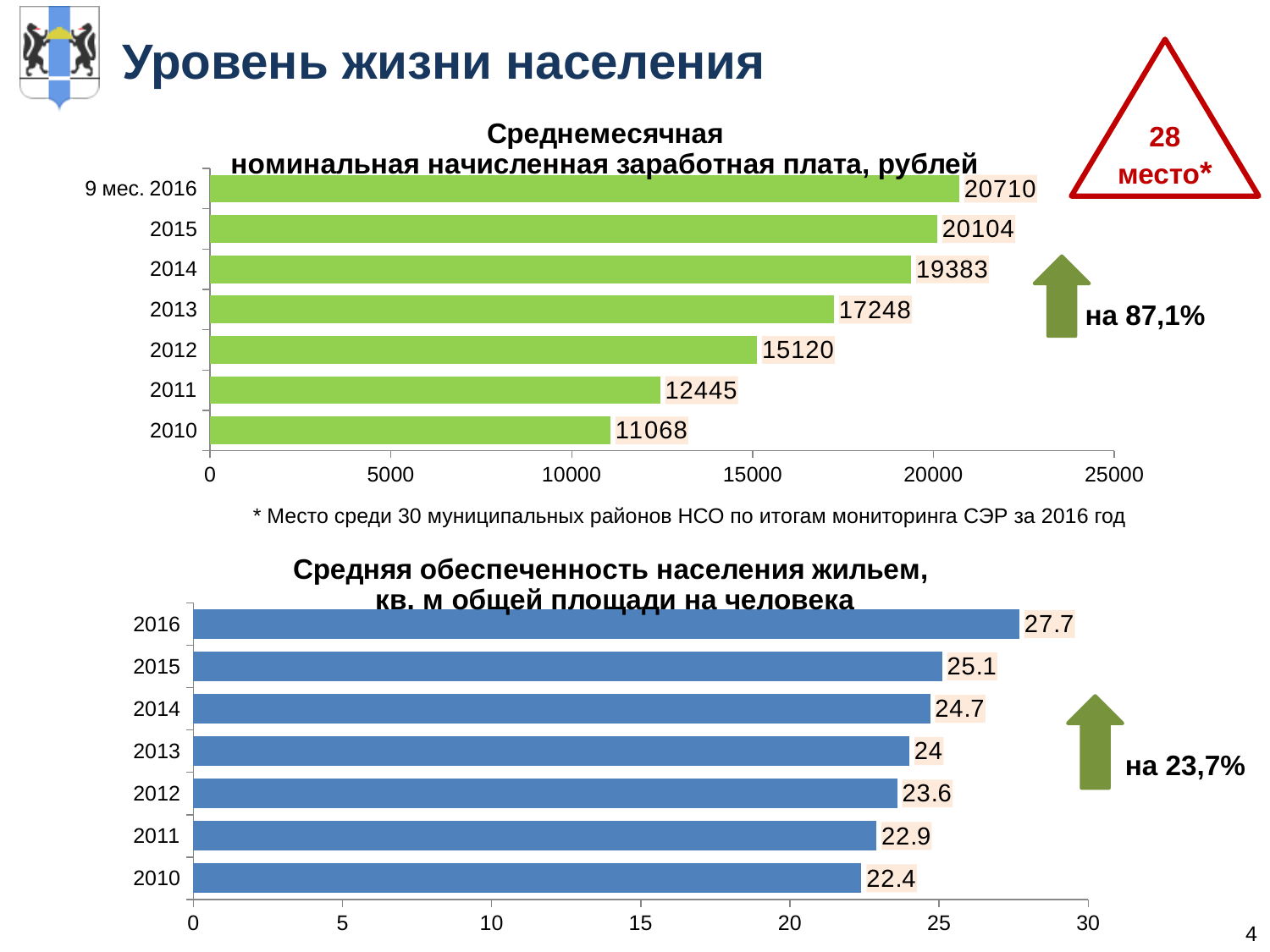
In the bottom chart (Средняя обеспеченность населения жильем), which is larger, the value for 2011 or the value for 2013? 2013 In the top chart (Среднемесячная номинальная начисленная заработная плата, рублей), what is the value for 2013? 17248 What type of chart is the bottom chart (Средняя обеспеченность населения жильем)? bar chart In the top chart (Среднемесячная номинальная начисленная заработная плата, рублей), how many categories are shown? 7 In the top chart (Среднемесячная номинальная начисленная заработная плата, рублей), which category has the lowest value? 2010 In the bottom chart (Средняя обеспеченность населения жильем), what is the difference between the values for 2016 and 2015? 2.6 In the top chart (Среднемесячная номинальная начисленная заработная плата, рублей), what is the value for 9 мес. 2016? 20710 What colour are the bars in the top chart (Среднемесячная номинальная начисленная заработная плата, рублей)? green In the top chart (Среднемесячная номинальная начисленная заработная плата, рублей), do the values rise or fall from 2010 to 9 мес. 2016? rise In the top chart (Среднемесячная номинальная начисленная заработная плата, рублей), what is the difference between the values for 2015 and 2014? 721 In the bottom chart (Средняя обеспеченность населения жильем), which year has the highest value? 2016 In the bottom chart (Средняя обеспеченность населения жильем), what is the value for 2012? 23.6